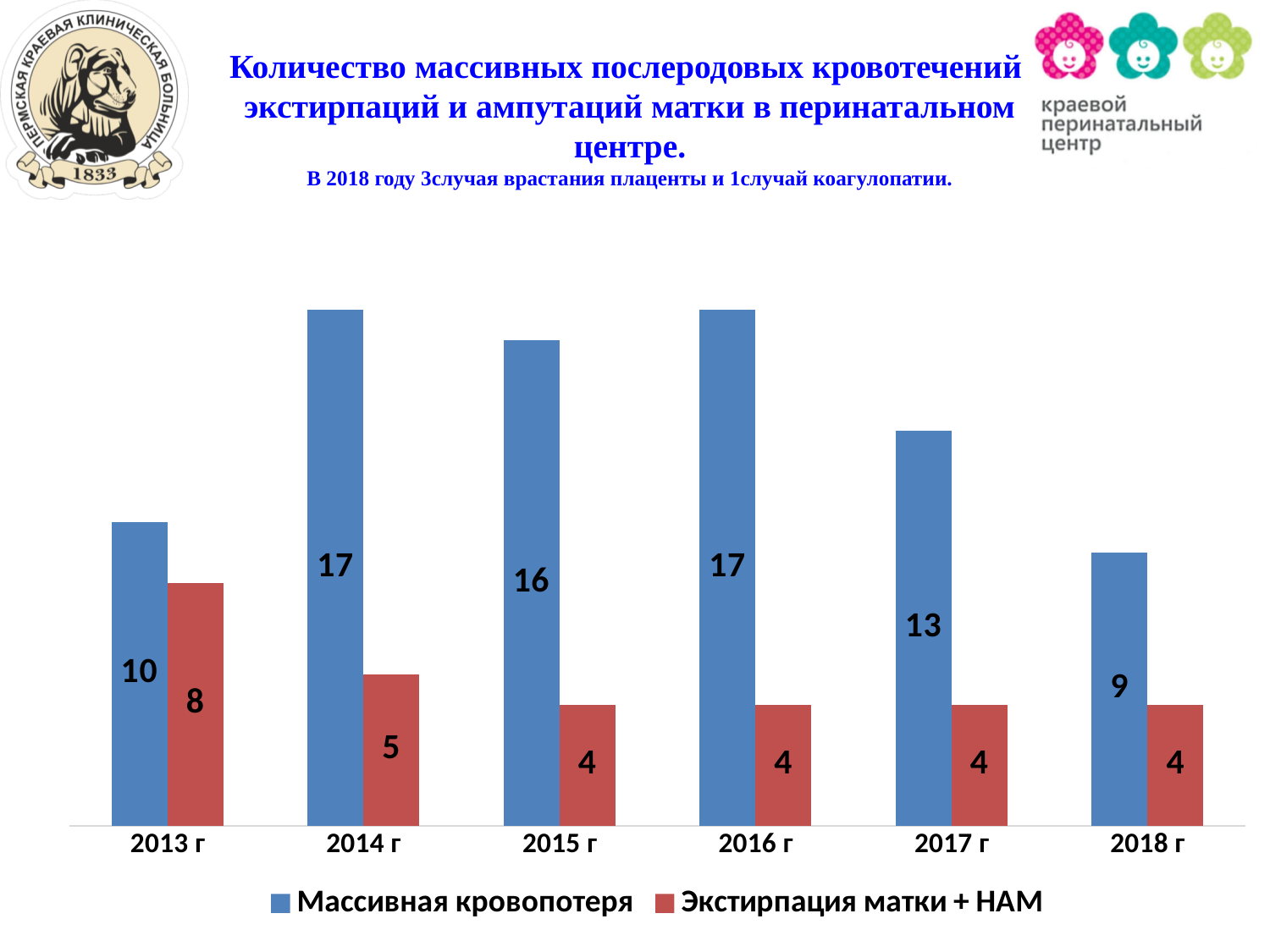
What kind of chart is shown on the slide? Bar chart Does the value for Массивная кровопотеря rise or fall from 2016 г to 2018 г? Fall Which year has the highest value for Экстирпация матки + НАМ? 2013 г How many years are shown on the x axis? 6 What colour are the bars for Экстирпация матки + НАМ? Red What is the value for Массивная кровопотеря in 2014 г? 17 How many series does the legend list? 2 What is the value for Массивная кровопотеря in 2018 г? 9 What is the difference between Массивная кровопотеря and Экстирпация матки + НАМ in 2017 г? 9 Which is larger: Массивная кровопотеря in 2015 г or Массивная кровопотеря in 2017 г? Массивная кровопотеря in 2015 г What is the value for Экстирпация матки + НАМ in 2013 г? 8 Which year has the lowest value for Массивная кровопотеря? 2018 г